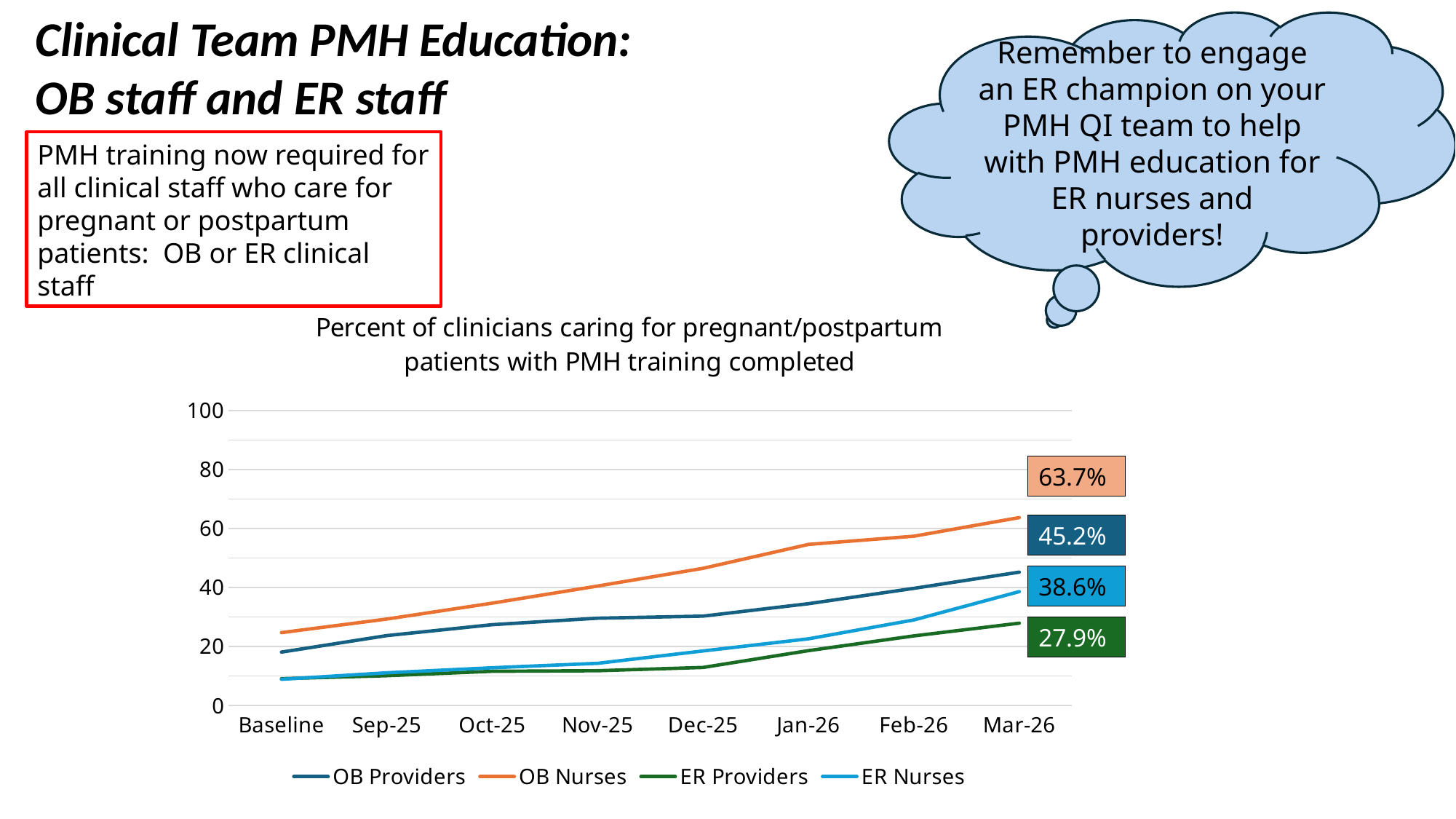
What is the value for ER Nurses at Mar-26? 38.6% What kind of chart is shown on the slide? Line chart How many time points are shown on the x axis? 8 Which series has the highest value at Mar-26? OB Nurses Is the value for OB Nurses at Baseline greater or less than 20? greater What is the value for OB Nurses at Mar-26? 63.7% Do the values for ER Nurses rise or fall from Baseline to Mar-26? Rise Which series has the lowest value at Mar-26? ER Providers What is the value for ER Providers at Mar-26? 27.9% What is the difference between the OB Nurses and OB Providers values at Mar-26? 18.5% How many series does the legend list? 4 What is the value for OB Providers at Mar-26? 45.2%